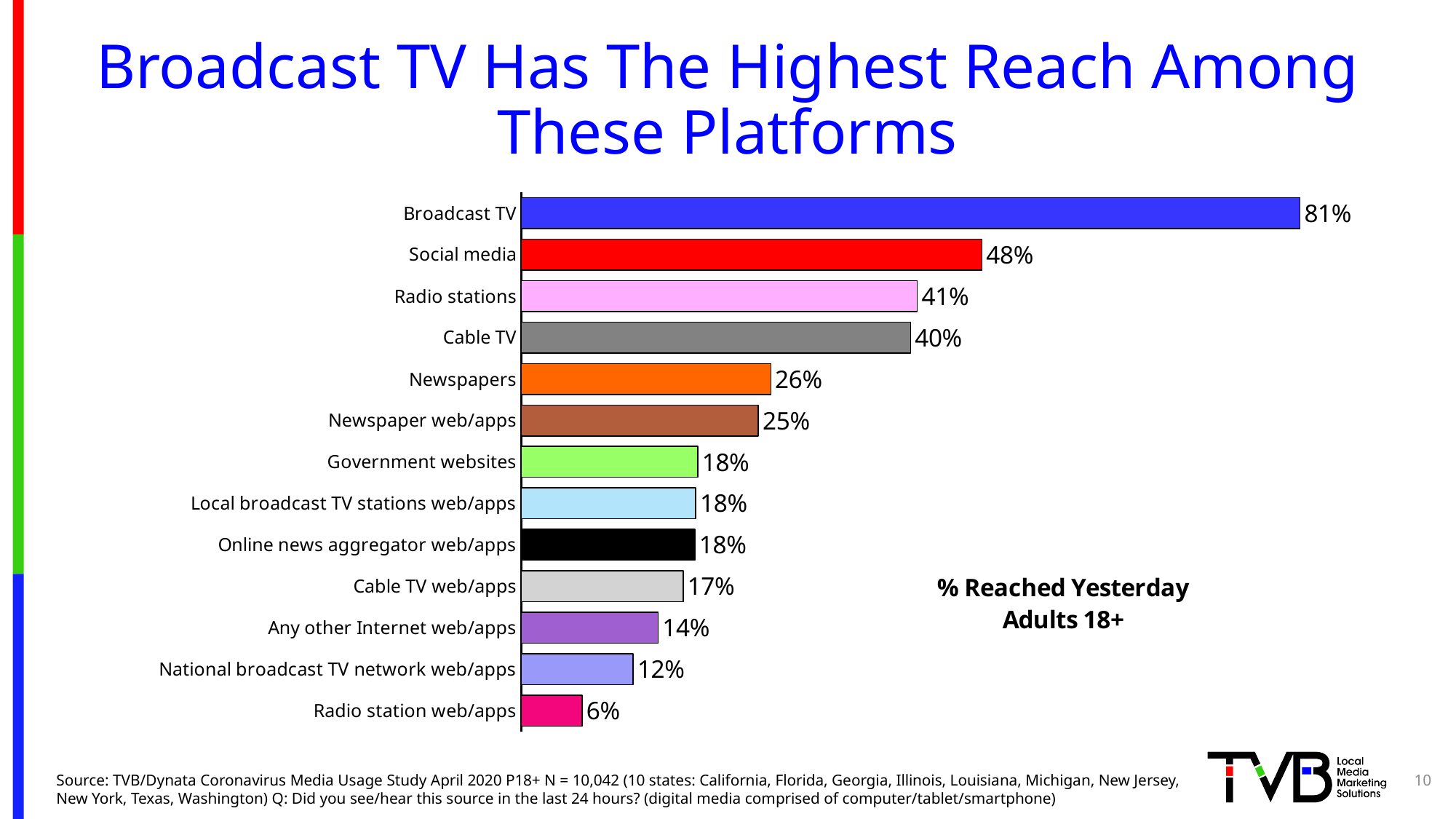
Which is larger, the value for Radio stations or the value for Cable TV? Radio stations Which platform has the lowest value? Radio station web/apps What is the value for Cable TV? 40% What is the difference between the values for Broadcast TV and Social media? 33% What text label appears inside the chart area describing the measure? % Reached Yesterday Adults 18+ What is the value for Broadcast TV? 81% Which platform has the highest value? Broadcast TV What is the difference between the values for Newspapers and Cable TV web/apps? 9% What is the value for Radio station web/apps? 6% What is the value for Newspaper web/apps? 25% How many platforms are shown in the chart? 13 What kind of chart is shown on the slide? Bar chart